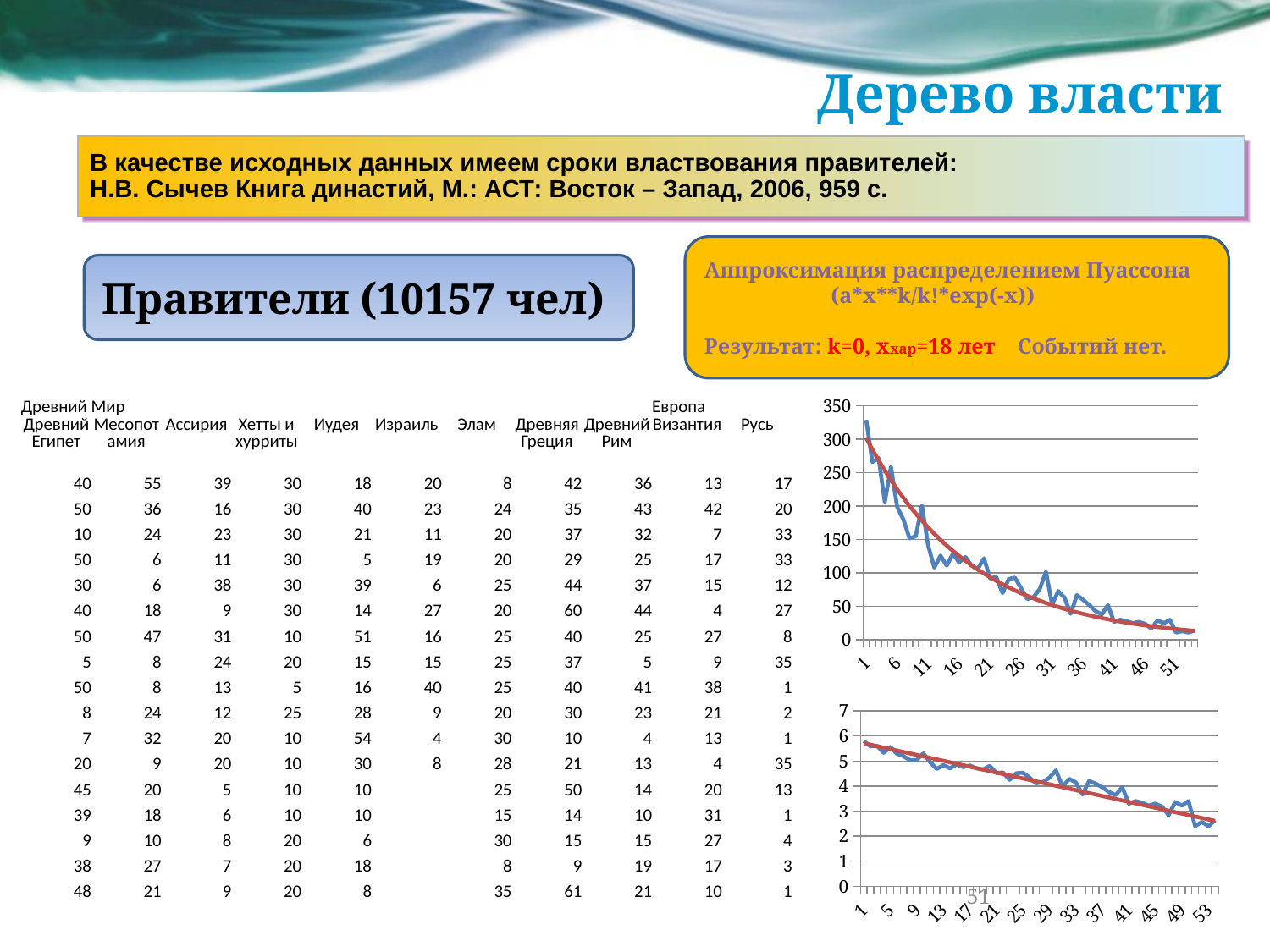
In the lower chart on the right, what is the highest value shown on the y axis? 7 In the upper chart on the right, what is the last tick label shown on the x axis? 51 In the lower chart on the right, is the value of the blue line at x = 1 greater or less than 5? greater What kind of chart is the upper chart on the right side of the slide? line chart In the upper chart on the right, is the value of the blue line at x = 1 greater or less than 300? greater In the lower chart on the right, do the values rise or fall as you move along the x axis? fall In the upper chart on the right, do the values rise or fall as you move along the x axis? fall In the upper chart on the right, is the value of the blue line at x = 51 greater or less than 50? less In the upper chart on the right, what is the highest value shown on the y axis? 350 In the lower chart on the right, what is the last tick label shown on the x axis? 53 What kind of chart is the lower chart on the right side of the slide? line chart